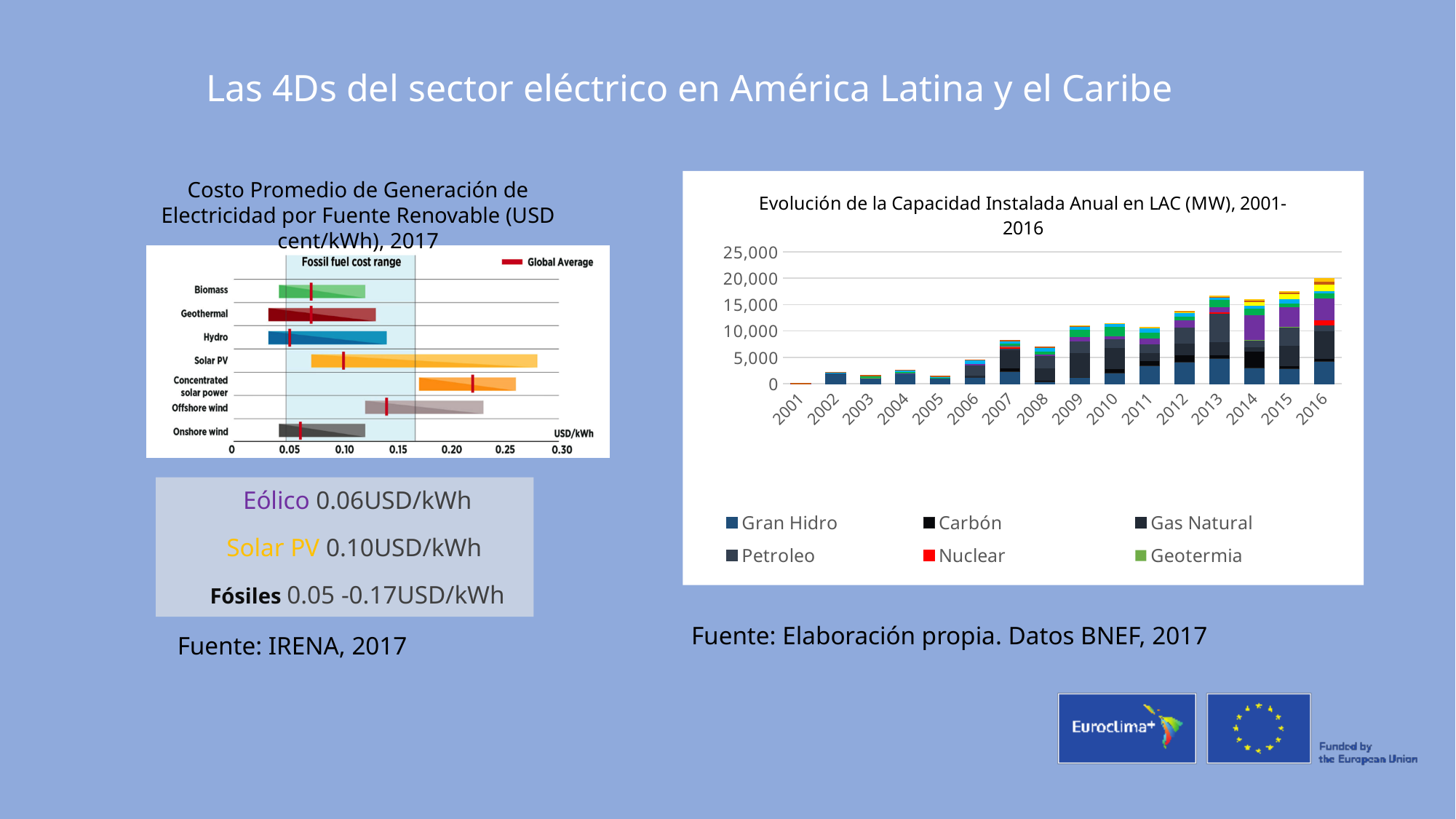
In the chart 'Evolución de la Capacidad Instalada Anual en LAC (MW), 2001-2016', which year has the highest total installed capacity? 2016 What type of chart is 'Evolución de la Capacidad Instalada Anual en LAC (MW), 2001-2016'? Stacked bar chart How many renewable sources are listed in the chart 'Costo Promedio de Generación de Electricidad por Fuente Renovable (USD cent/kWh), 2017'? 7 In the chart 'Costo Promedio de Generación de Electricidad por Fuente Renovable (USD cent/kWh), 2017', what does the red marker in the legend represent? Global Average In the chart 'Evolución de la Capacidad Instalada Anual en LAC (MW), 2001-2016', which year has the lowest total installed capacity? 2001 In the chart 'Evolución de la Capacidad Instalada Anual en LAC (MW), 2001-2016', do the total values generally rise or fall from 2001 to 2016? rise In the chart 'Evolución de la Capacidad Instalada Anual en LAC (MW), 2001-2016', how many years are shown on the x axis? 16 In the chart 'Evolución de la Capacidad Instalada Anual en LAC (MW), 2001-2016', is the total for 2002 greater or less than 5,000? less In the chart 'Evolución de la Capacidad Instalada Anual en LAC (MW), 2001-2016', which is larger, the total for 2012 or the total for 2008? 2012 In the chart 'Evolución de la Capacidad Instalada Anual en LAC (MW), 2001-2016', is the total for 2013 greater or less than 15,000? greater In the chart 'Costo Promedio de Generación de Electricidad por Fuente Renovable (USD cent/kWh), 2017', is the global average for Concentrated solar power greater or less than 0.20 USD/kWh? greater How many series does the legend of the chart 'Evolución de la Capacidad Instalada Anual en LAC (MW), 2001-2016' list? 6